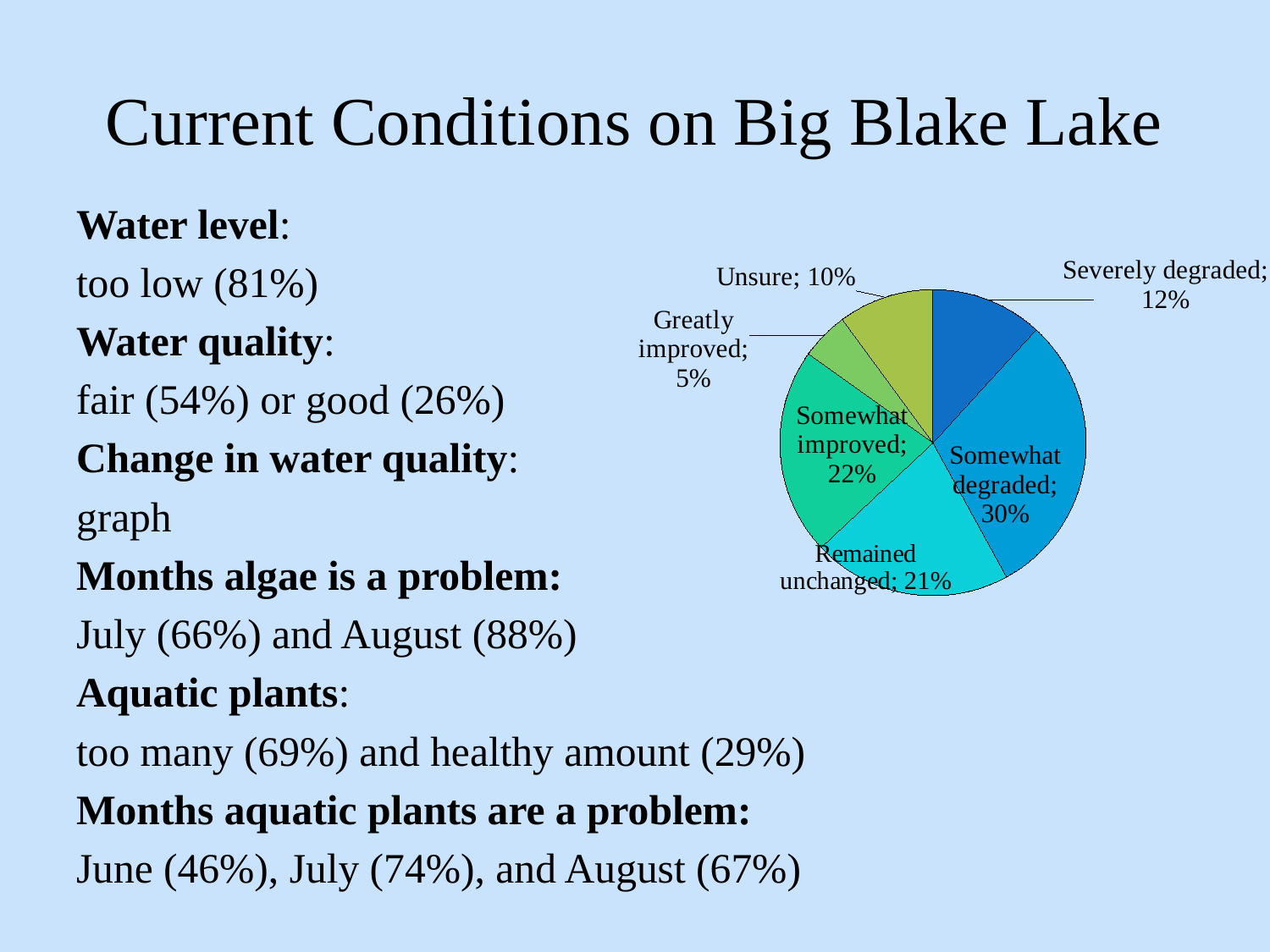
What kind of chart is shown on the slide? pie chart What is the combined percentage of the 'Severely degraded' and 'Somewhat degraded' slices? 42% Which slice of the pie chart is the largest? Somewhat degraded What percentage of the pie is labelled 'Severely degraded'? 12% Which slice is larger, 'Remained unchanged' or 'Unsure'? Remained unchanged What percentage of the pie is labelled 'Unsure'? 10% Which slice of the pie chart is the smallest? Greatly improved What percentage of the pie is labelled 'Somewhat degraded'? 30% What percentage of the pie is labelled 'Greatly improved'? 5% What is the difference in percentage points between the 'Somewhat degraded' and 'Somewhat improved' slices? 8 What percentage of the pie is labelled 'Remained unchanged'? 21% How many slices does the pie chart have? 6